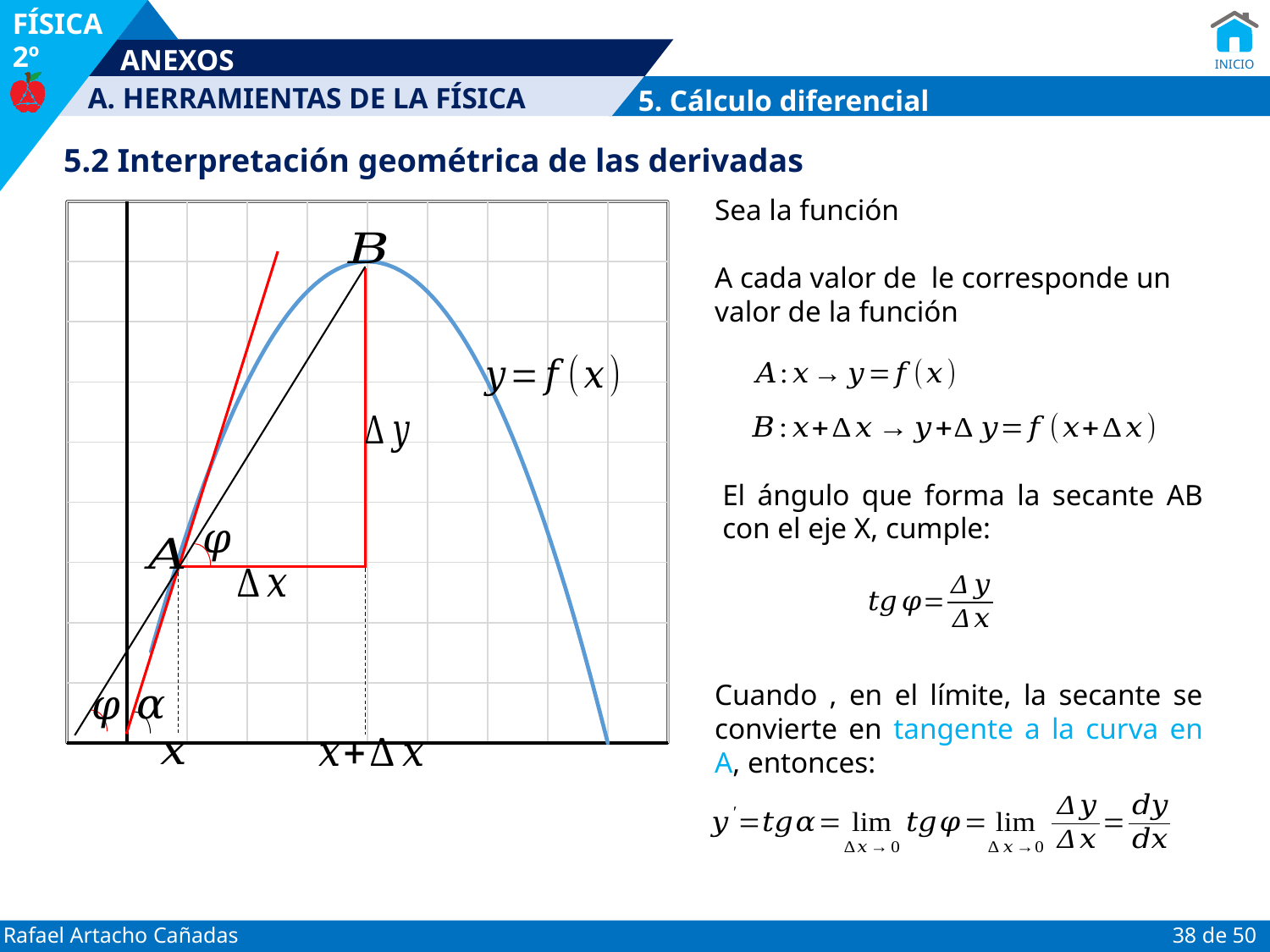
Does the blue curve rise or fall to the right of point B? fall Does the blue curve rise or fall as x increases from point A to point B? rise What kind of chart is shown on the left of the slide? line chart What label is written next to the blue curve? y=f(x) What label is written on the horizontal red segment between the two dashed lines? Δx How many labelled points are marked on the blue curve? 2